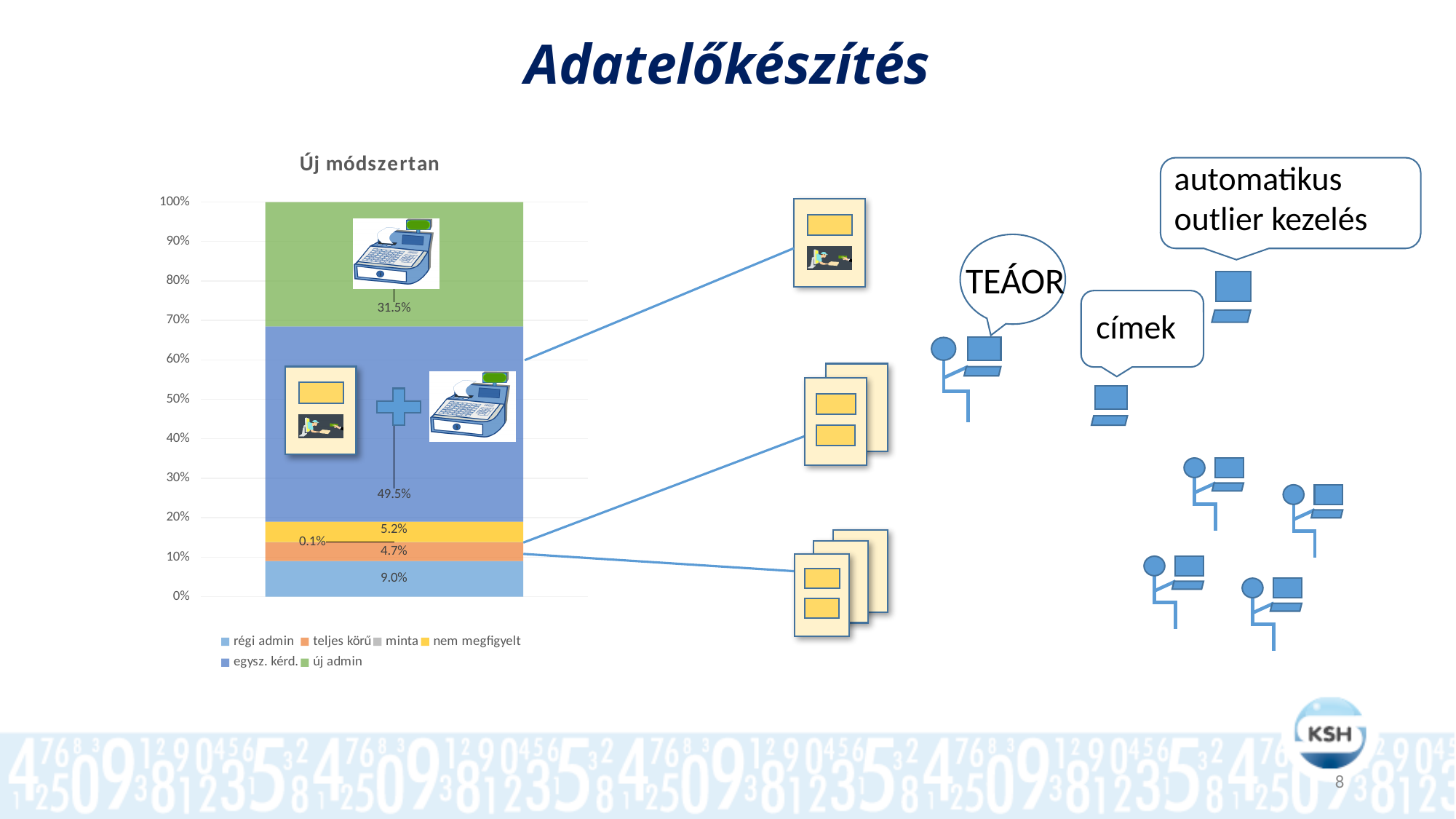
What is the value of the 'régi admin' segment in the chart? 9.0% What is the value of the 'új admin' segment in the chart? 31.5% What is the value of the 'egysz. kérd.' segment in the chart? 49.5% What is the difference between the 'egysz. kérd.' and 'új admin' values? 18.0% What is the value of the 'minta' segment in the chart? 0.1% Which segment of the bar has the largest value? egysz. kérd. What kind of chart is shown on the slide? stacked bar chart Which segment of the bar has the smallest value? minta How many series does the chart legend list? 6 What is the value of the 'nem megfigyelt' segment in the chart? 5.2% What is the title of the chart? Új módszertan What is the value of the 'teljes körű' segment in the chart? 4.7%